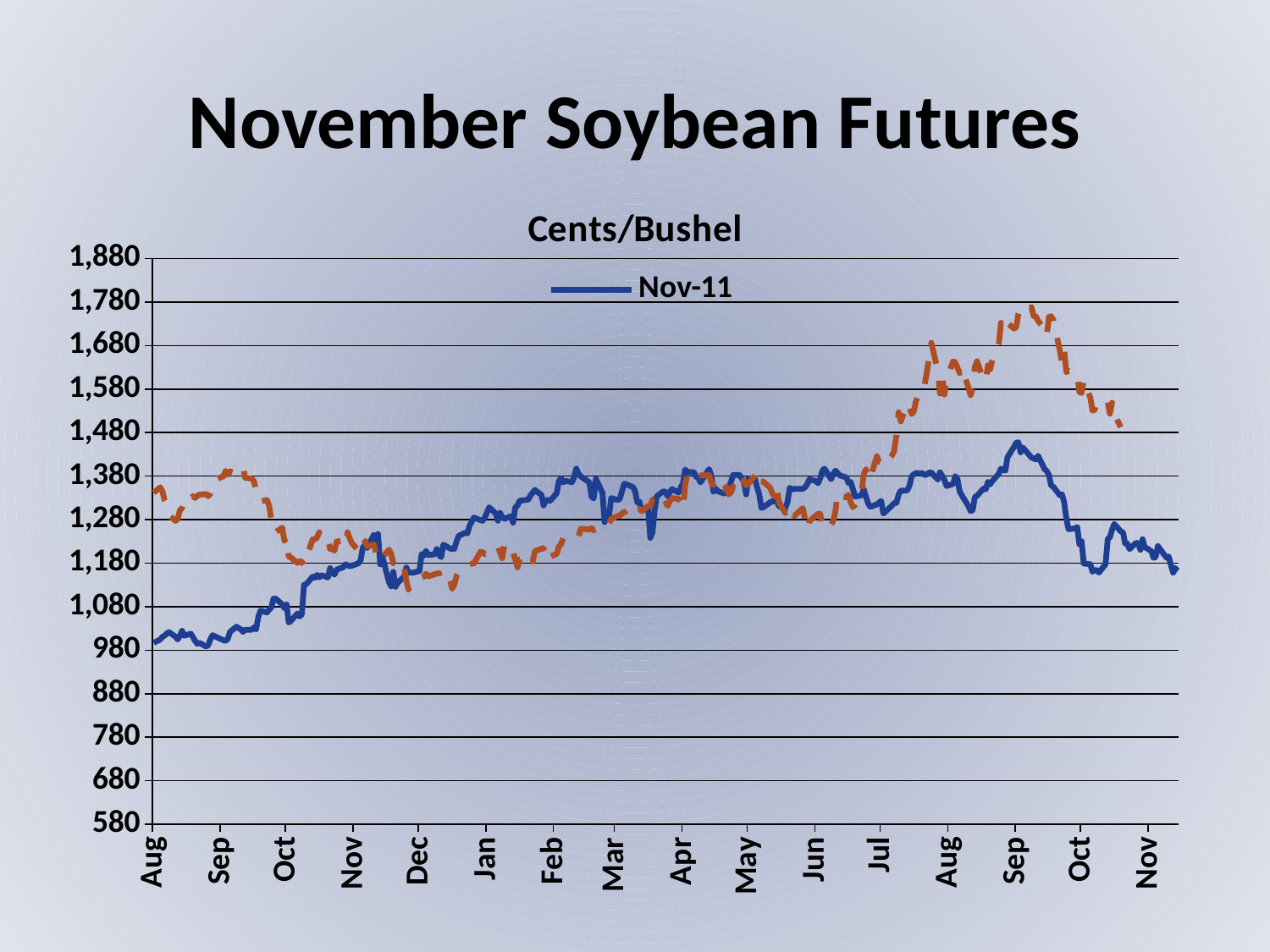
How many month labels are shown along the x axis? 16 What is the title shown above the chart's plot area? Cents/Bushel What series name appears in the chart legend? Nov-11 Is the Nov-11 value at the Apr label greater or less than 1,280? greater Does the Nov-11 line generally rise or fall from the second Sep label to the final Nov label? fall Does the Nov-11 line generally rise or fall from the first Aug label to the Feb label? rise What kind of chart is shown on the slide? line chart How many series does the chart legend list? 1 Is the Nov-11 value at the second Sep label greater or less than 1,380? greater Is the Nov-11 value at the final Nov label greater or less than 1,280? less